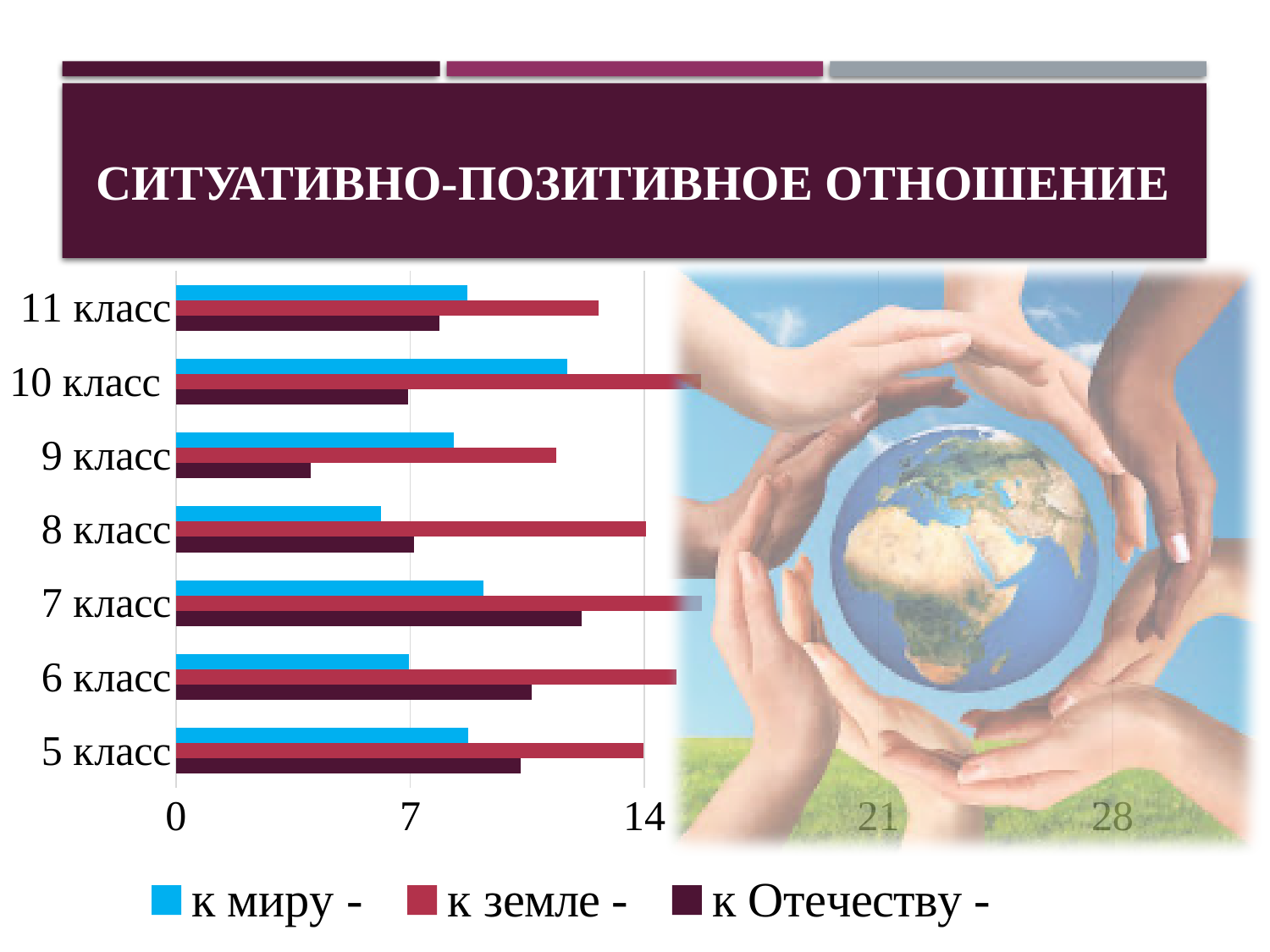
Which class has the lowest value for 'к Отечеству'? 9 класс Is the value for 'к миру' in 8 класс greater or less than 7? less How many series does the chart legend list? 3 Is the value for 'к Отечеству' in 7 класс greater or less than 7? greater In 9 класс, which is larger: the value for 'к земле' or for 'к Отечеству'? к земле In 10 класс, which is larger: the value for 'к миру' or for 'к Отечеству'? к миру What kind of chart is shown on the slide? bar chart Is the value for 'к земле' in 10 класс greater or less than 14? greater How many classes (categories) are shown on the chart? 7 Which class has the highest value for 'к миру'? 10 класс What is the title of the slide above the chart? СИТУАТИВНО-ПОЗИТИВНОЕ ОТНОШЕНИЕ